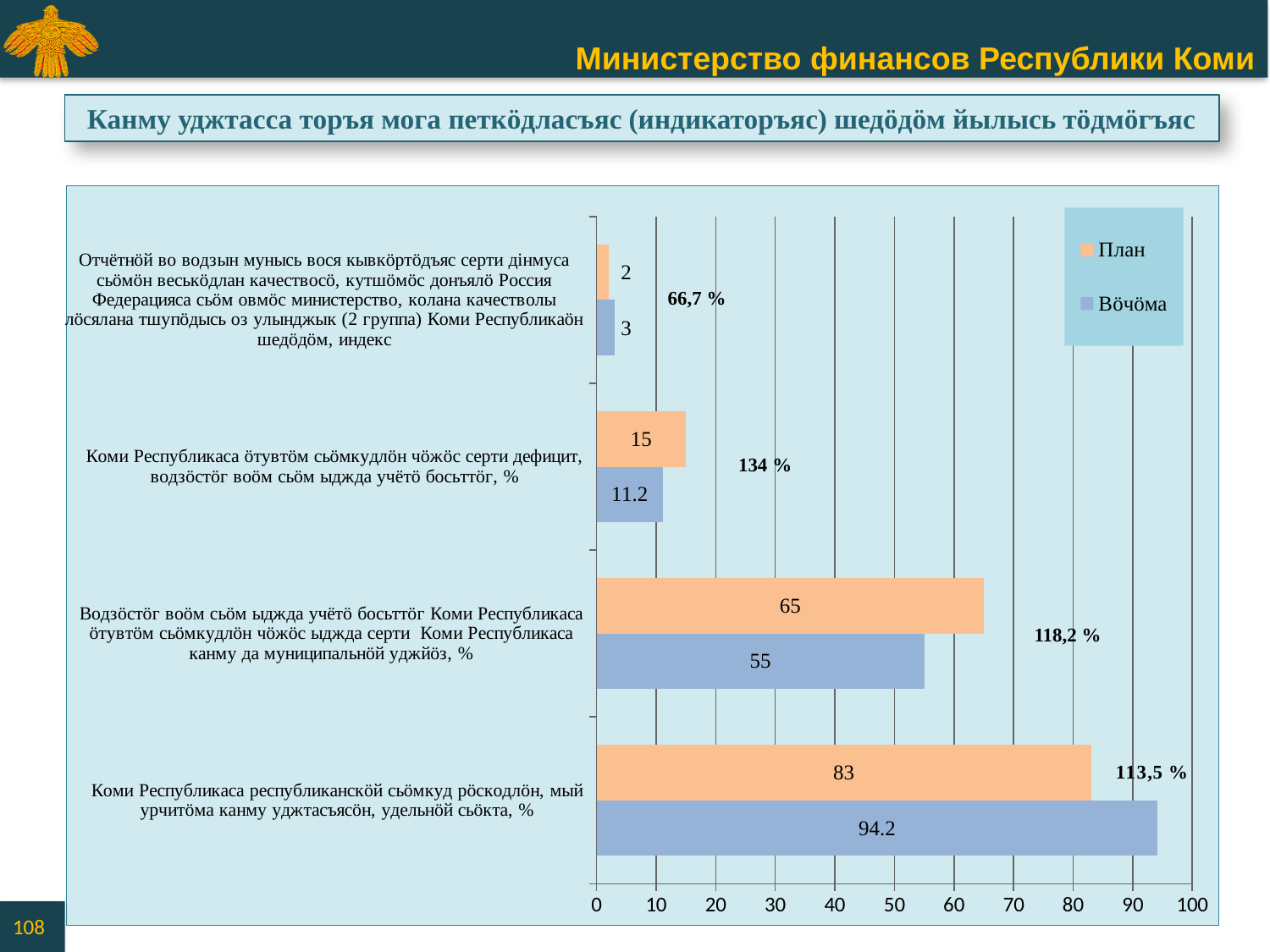
What is the План value for the bottom category (Коми Республикаса республиканскöй сьöмкуд рöскодлöн ... удельнöй сьöкта, %)? 83 What is the Вöчöма value for the category 'Коми Республикаса öтувтöм сьöмкудлöн чöжöс серти дефицит ...'? 11.2 How many series does the chart legend list? 2 What is the difference between the План and Вöчöма values for the category 'Водзöстöг воöм сьöм ыджда учётö босьттöг ...'? 10 For the bottom category (удельнöй сьöкта, %), which is larger: the План value or the Вöчöма value? Вöчöма Which category has the highest Вöчöма value? Коми Республикаса республиканскöй сьöмкуд рöскодлöн, мый урчитöма канму уджтасъясöн, удельнöй сьöкта, % Which category has the lowest План value? Отчётнöй во водзын мунысь вося кывкöртöдъяс серти дiнмуса сьöмöн веськöдлан качествосö ... шедöдöм, индекс How many categories are plotted on the chart? 4 What type of chart is shown on the slide? bar chart What is the Вöчöма value for the bottom category (Коми Республикаса республиканскöй сьöмкуд рöскодлöн ... удельнöй сьöкта, %)? 94.2 What percentage label is shown next to the top category (the index category)? 66,7 % What is the План value for the category 'Водзöстöг воöм сьöм ыджда учётö босьттöг ...'? 65